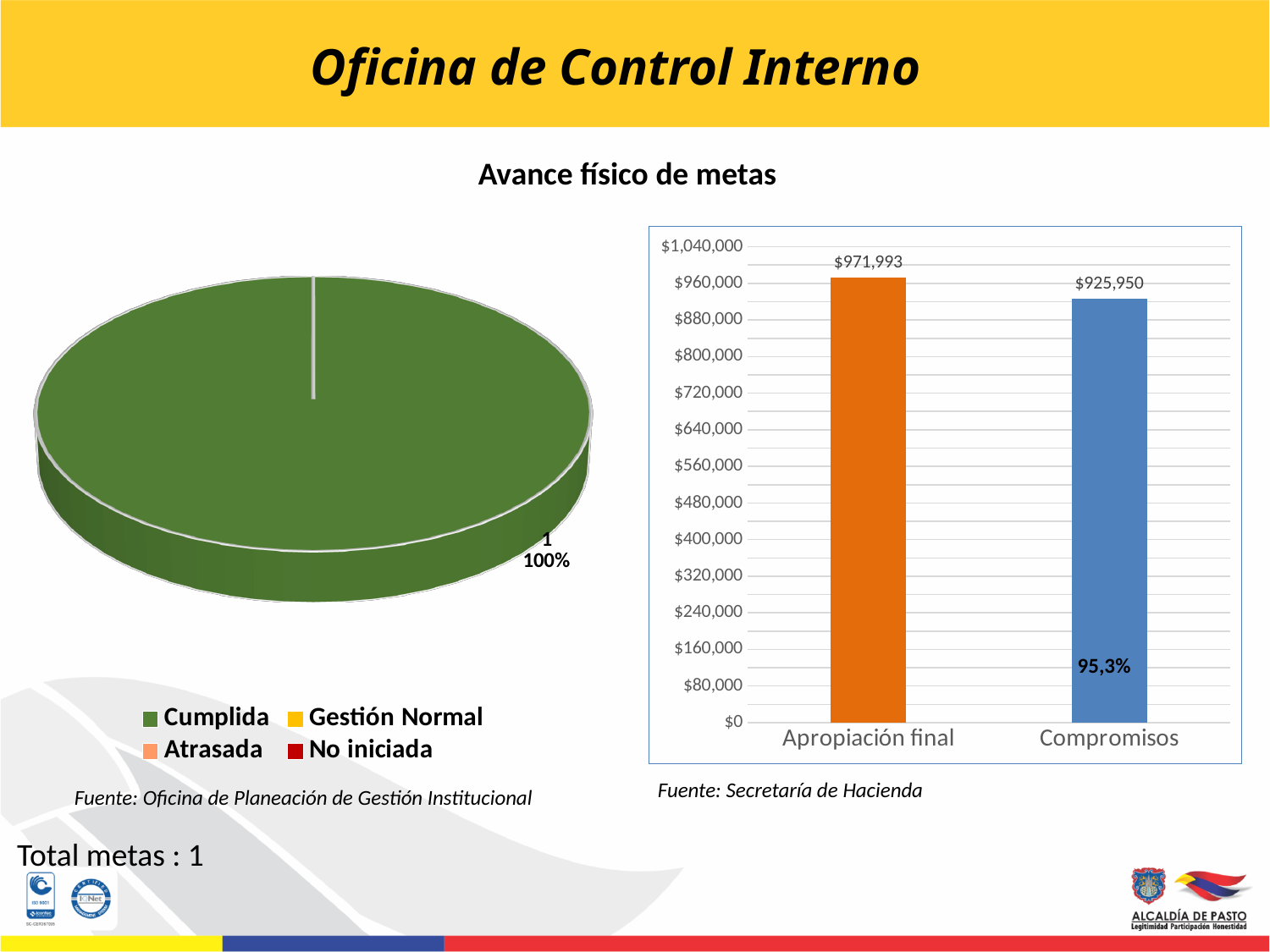
In the bar chart on the right, what percentage label is shown on the Compromisos bar? 95,3% In the pie chart on the left, which legend entry is shown in green? Cumplida What kind of chart is the chart on the right of the slide? bar chart In the bar chart on the right, what is the value for Apropiación final? $971,993 In the bar chart on the right, what is the value for Compromisos? $925,950 In the pie chart on the left, what share does the Cumplida slice represent? 100% What kind of chart is the chart on the left of the slide? pie chart How many entries does the legend of the pie chart on the left list? 4 In the bar chart on the right, is the value for Compromisos greater or less than $880,000? greater In the bar chart on the right, which category has the higher value, Apropiación final or Compromisos? Apropiación final In the bar chart on the right, what is the difference between Apropiación final and Compromisos? $46,043 In the bar chart on the right, how many categories are shown on the x axis? 2